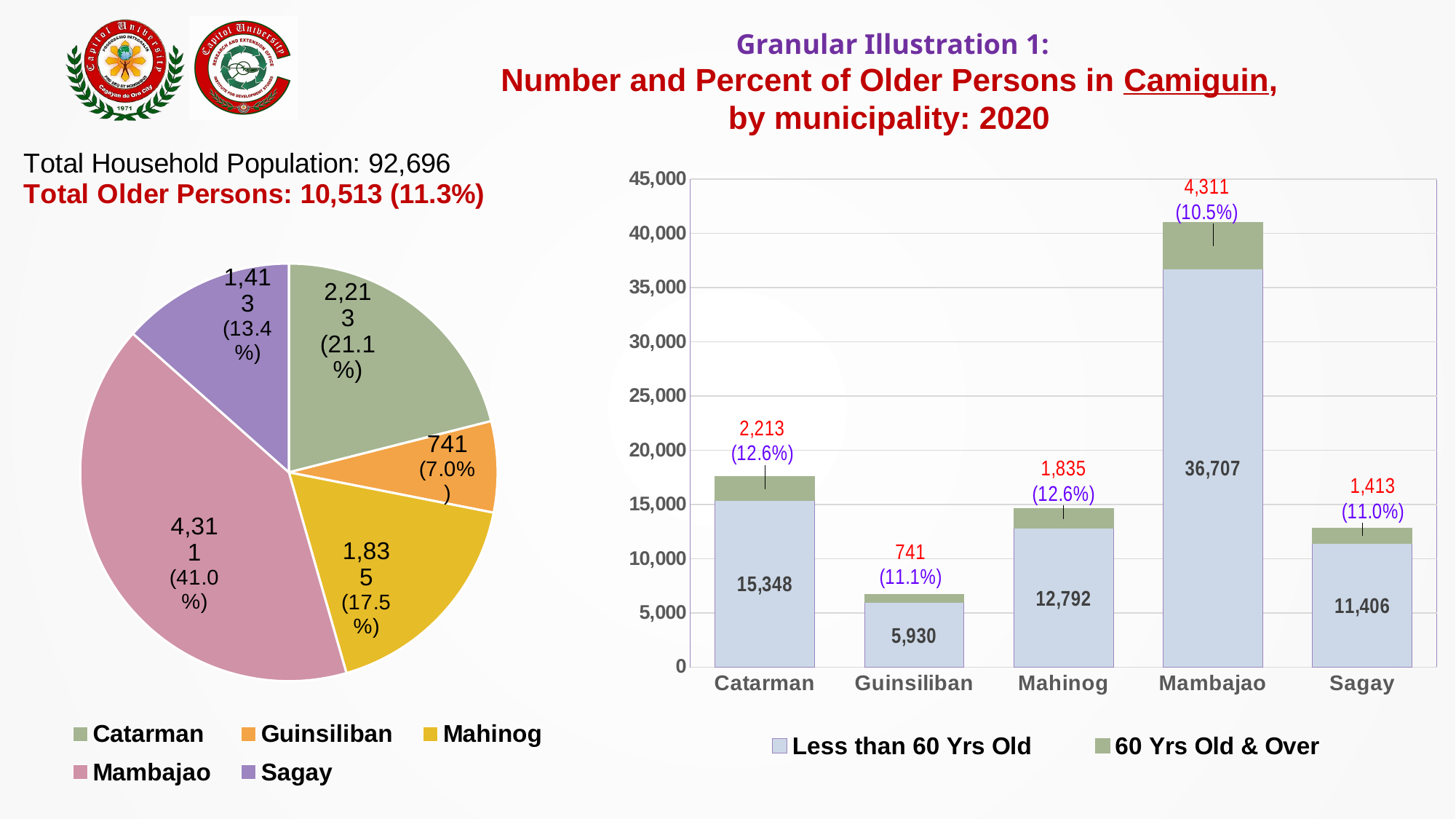
In the bar chart on the right, what is the difference between the Less than 60 Yrs Old values for Mahinog and Sagay? 1,386 In the pie chart on the left, which municipality has the smallest slice? Guinsiliban What kind of chart is shown on the right side of the slide? Stacked bar chart In the bar chart on the right, what is the total of the stacked bar for Catarman? 17,561 In the pie chart on the left, how many slices are there? 5 In the bar chart on the right, which municipality has the highest value for Less than 60 Yrs Old? Mambajao In the bar chart on the right, what is the value for Less than 60 Yrs Old in Guinsiliban? 5,930 In the pie chart on the left, what is the value shown for Mambajao? 4,311 In the bar chart on the right, how many series does the legend list? 2 In the bar chart on the right, which is larger: the Less than 60 Yrs Old value for Catarman or for Mahinog? Catarman In the bar chart on the right, what is the value for 60 Yrs Old & Over in Sagay? 1,413 In the pie chart on the left, what share of the pie does Mahinog represent? 17.5%